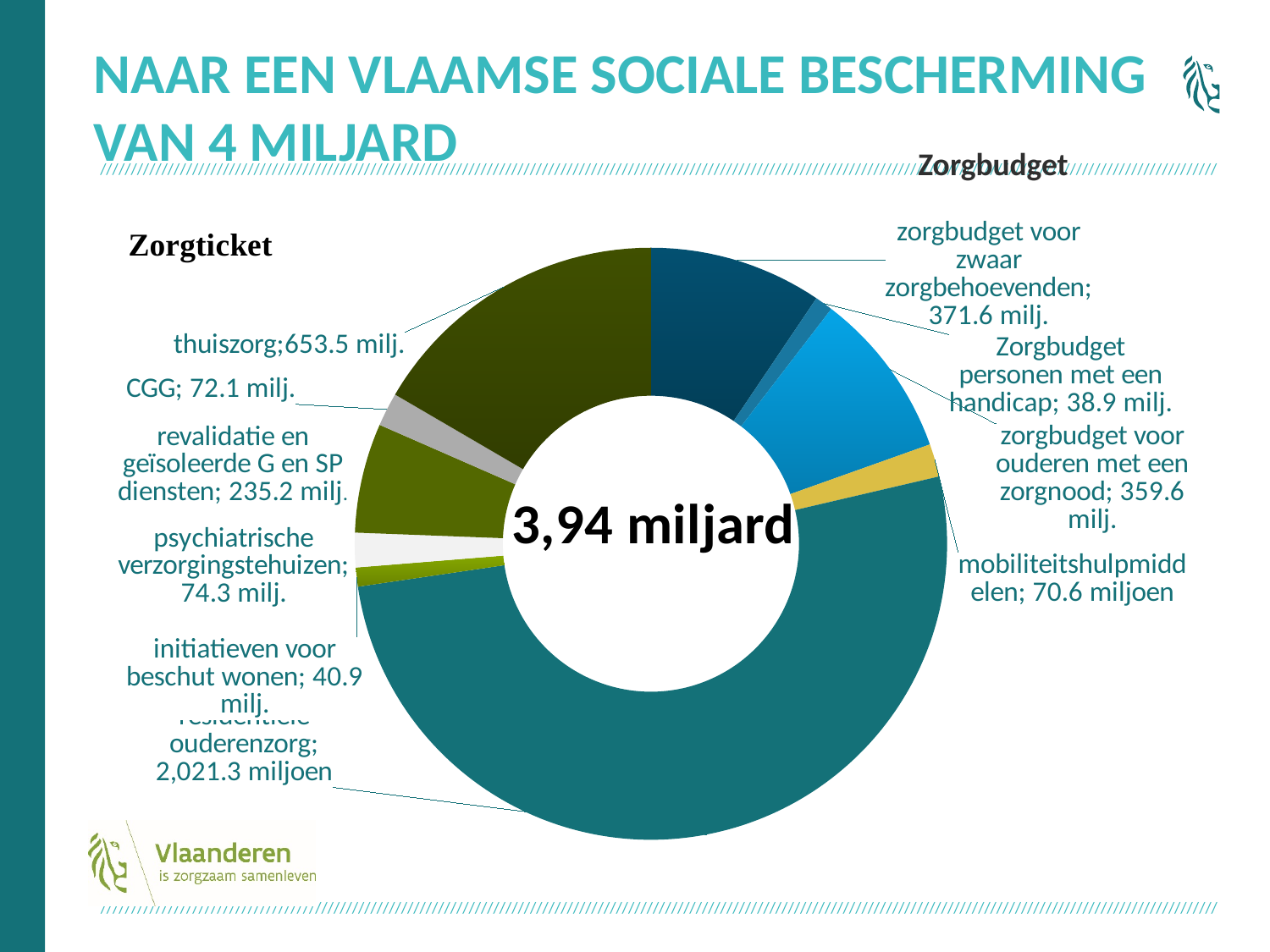
What is the difference between zorgbudget voor zwaar zorgbehoevenden and zorgbudget voor ouderen met een zorgnood? 12.0 milj. What value is shown for mobiliteitshulpmiddelen? 70.6 miljoen Which category has the largest value in the chart? residentiële ouderenzorg (2,021.3 miljoen) What value is shown for revalidatie en geïsoleerde G en SP diensten? 235.2 milj. Which is larger: CGG or psychiatrische verzorgingstehuizen? psychiatrische verzorgingstehuizen Which category has the smallest value in the chart? Zorgbudget personen met een handicap (38.9 milj.) What is the difference between the values for thuiszorg and revalidatie en geïsoleerde G en SP diensten? 418.3 milj. What value is shown for zorgbudget voor zwaar zorgbehoevenden? 371.6 milj. What value is shown for thuiszorg? 653.5 milj. What total is printed in the centre of the doughnut chart? 3,94 miljard How many categories (slices) does the chart have? 10 What kind of chart is shown on the slide? Doughnut (pie) chart